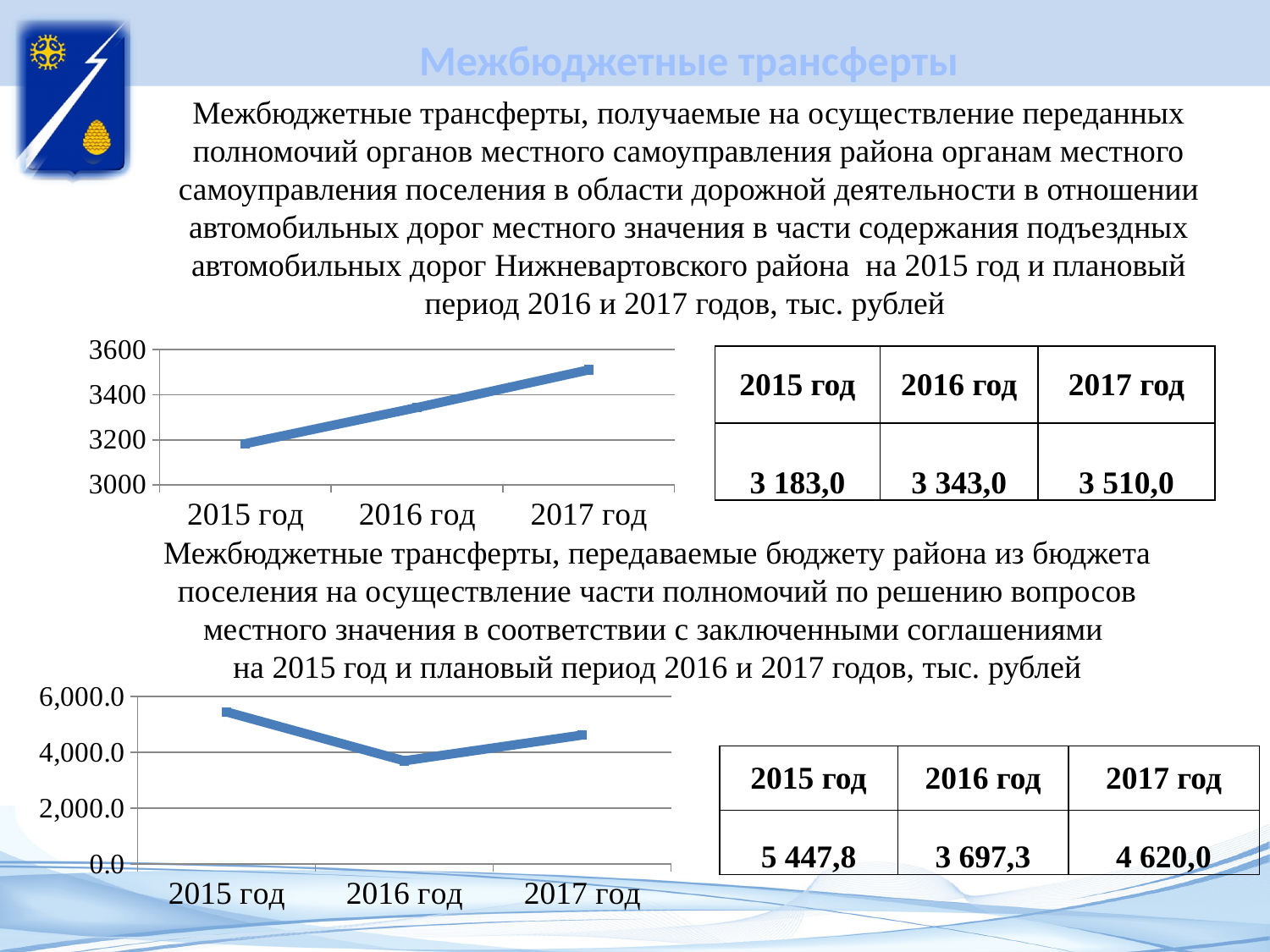
What kind of chart is the upper chart on the slide? line chart In the upper chart, what is the value for 2016 год? 3 343,0 In the upper chart, what is the difference between the values for 2017 год and 2015 год? 327,0 In the lower chart, what is the difference between the values for 2017 год and 2016 год? 922,7 In the lower chart, is the value for 2016 год greater or less than 4,000.0? less In the upper chart, do the values rise or fall from 2015 год to 2017 год? rise In the upper chart, which year has the lowest value? 2015 год How many data points are plotted in the upper chart? 3 In the lower chart, which is larger, the value for 2015 год or the value for 2017 год? 2015 год In the lower chart, what is the value for 2015 год? 5 447,8 In the upper chart, which year has the highest value? 2017 год In the lower chart, which year has the lowest value? 2016 год